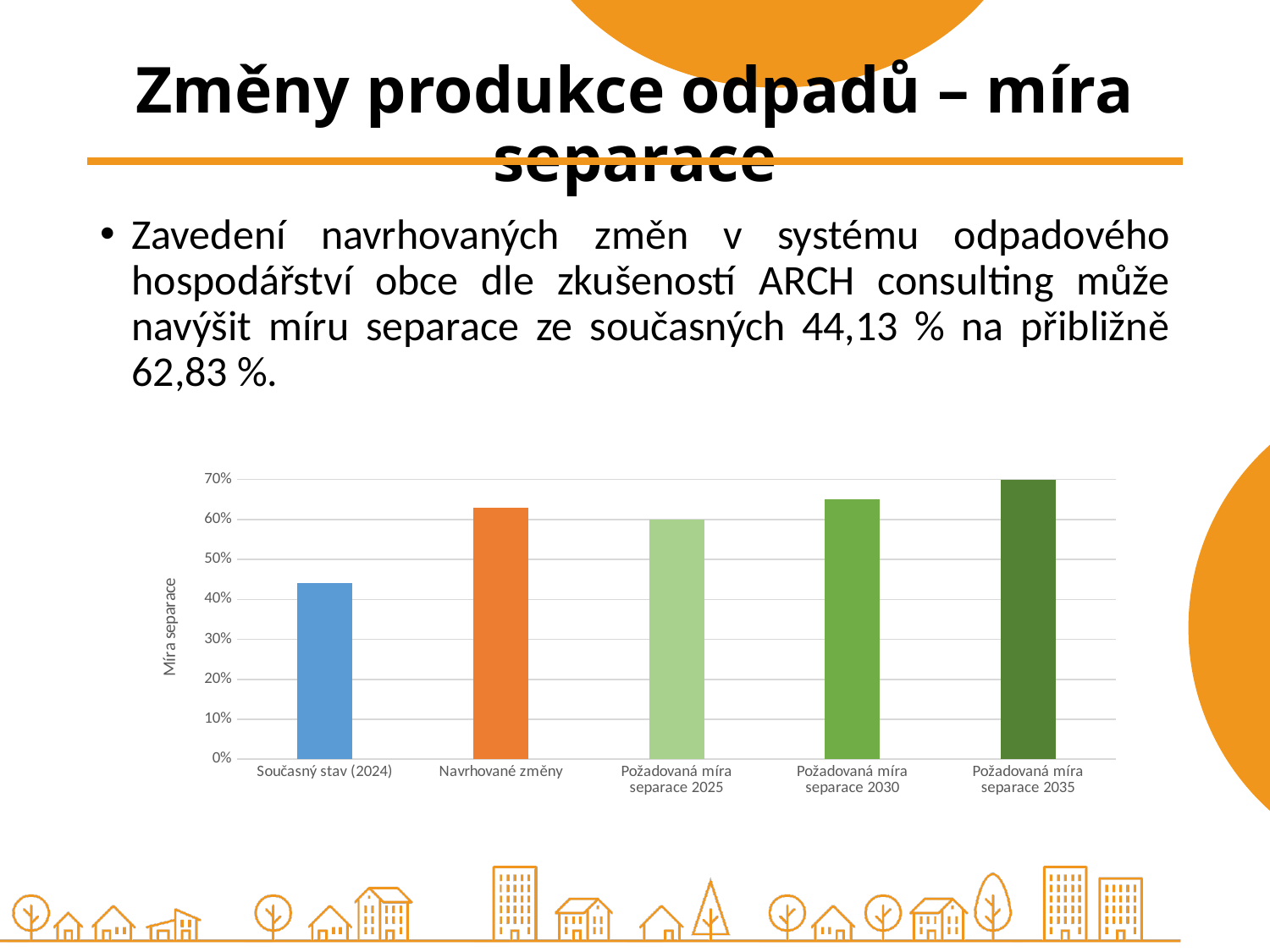
Which is larger: Požadovaná míra separace 2030 or Požadovaná míra separace 2025? Požadovaná míra separace 2030 Is the value for Požadovaná míra separace 2030 greater or less than 60%? greater Is the value for Navrhované změny greater or less than 60%? greater Is the value for Současný stav (2024) greater or less than 50%? less Which category has the lowest value in the chart? Současný stav (2024) Do the values rise or fall across the three Požadovaná míra separace bars from 2025 to 2035? rise What is the value for Požadovaná míra separace 2035? 70% Which category has the highest value in the chart? Požadovaná míra separace 2035 What kind of chart is shown on the slide? bar chart What is the value for Požadovaná míra separace 2025? 60% What is the difference between Požadovaná míra separace 2035 and Požadovaná míra separace 2025? 10% How many categories (bars) does the chart show? 5